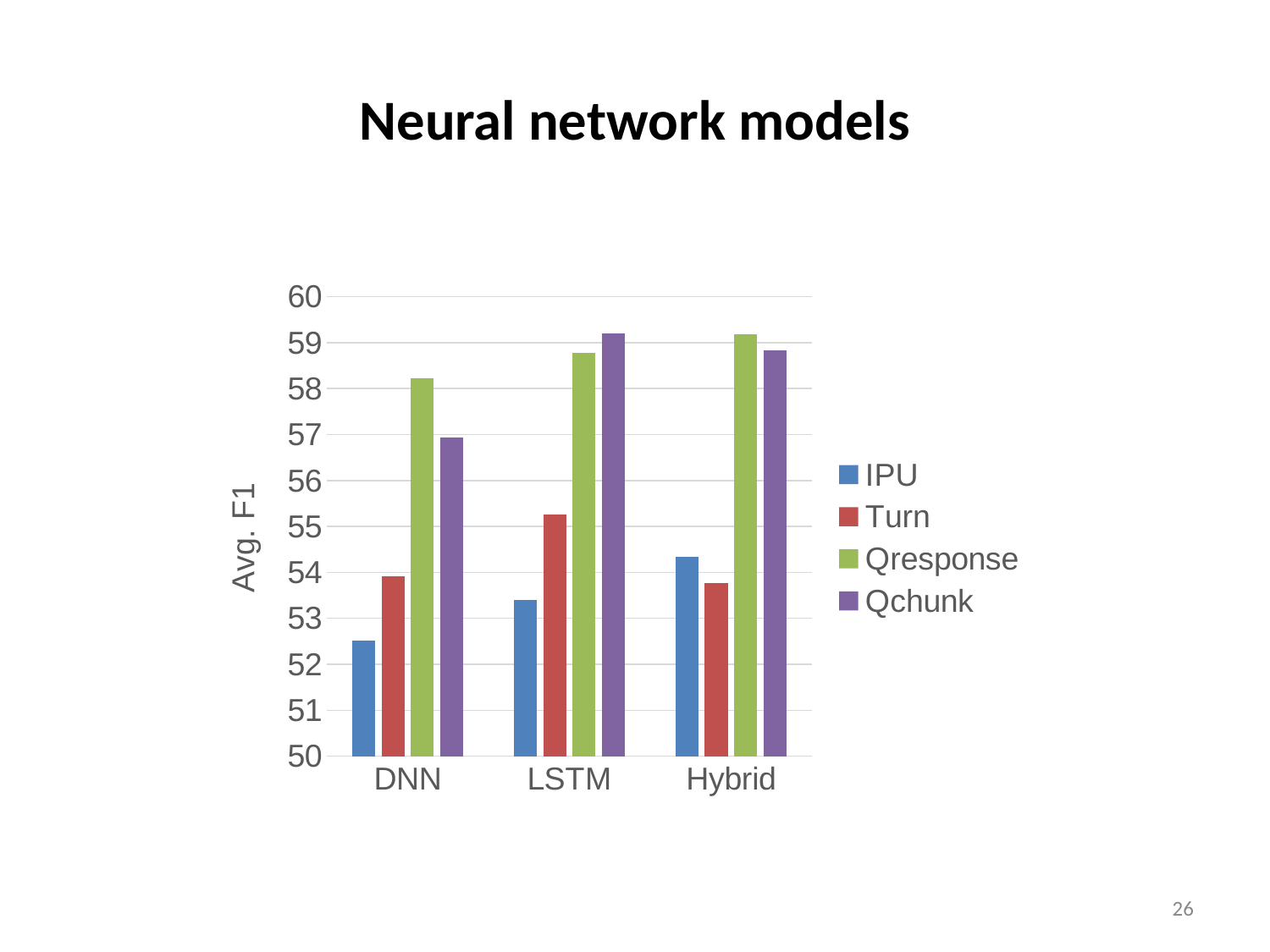
How many series does the legend list? 4 What kind of chart is shown on the slide? bar chart Is the IPU value for DNN greater or less than 53? less Which series has the lowest value for DNN? IPU Is the Turn value for LSTM greater or less than 55? greater Which model has the highest IPU value? Hybrid For DNN, which is larger, the Qresponse value or the Qchunk value? Qresponse Is the Qchunk value for DNN greater or less than 56? greater What is the label of the vertical axis? Avg. F1 How many neural network models (categories) are shown on the x axis? 3 Do the IPU values rise or fall moving from DNN to LSTM to Hybrid? rise